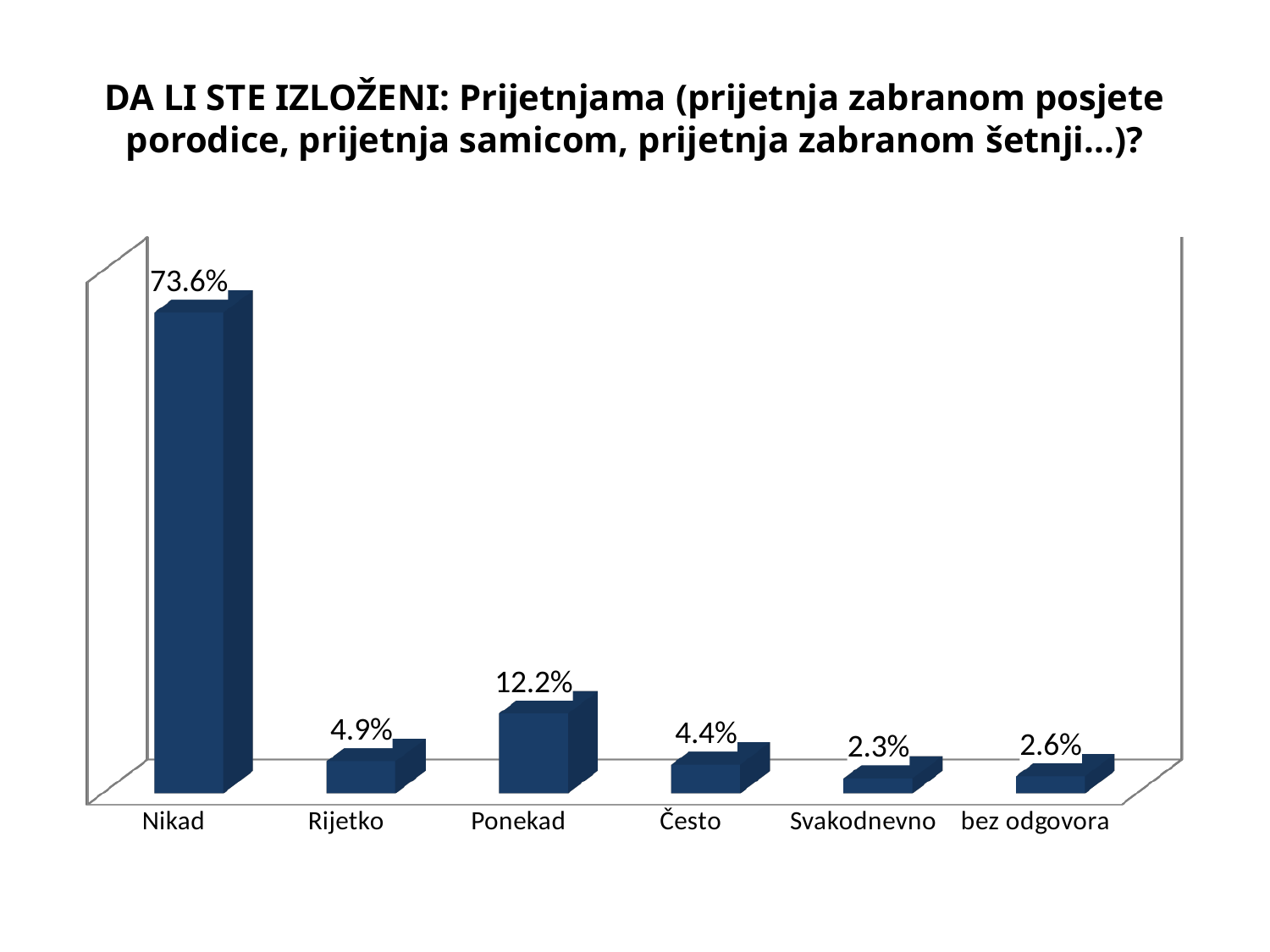
What is the value for Ponekad? 12.2% What is the difference between the values for Rijetko and Često? 0.5% Which category has the lowest value? Svakodnevno Which category has the highest value? Nikad What is the value for Nikad? 73.6% What is the title of the chart? DA LI STE IZLOŽENI: Prijetnjama (prijetnja zabranom posjete porodice, prijetnja samicom, prijetnja zabranom šetnji...)? What is the difference between the values for Nikad and Ponekad? 61.4% What kind of chart is shown on the slide? bar chart What is the value for bez odgovora? 2.6% How many categories are shown on the x axis? 6 Which is larger, the value for Rijetko or the value for Često? Rijetko What is the value for Svakodnevno? 2.3%